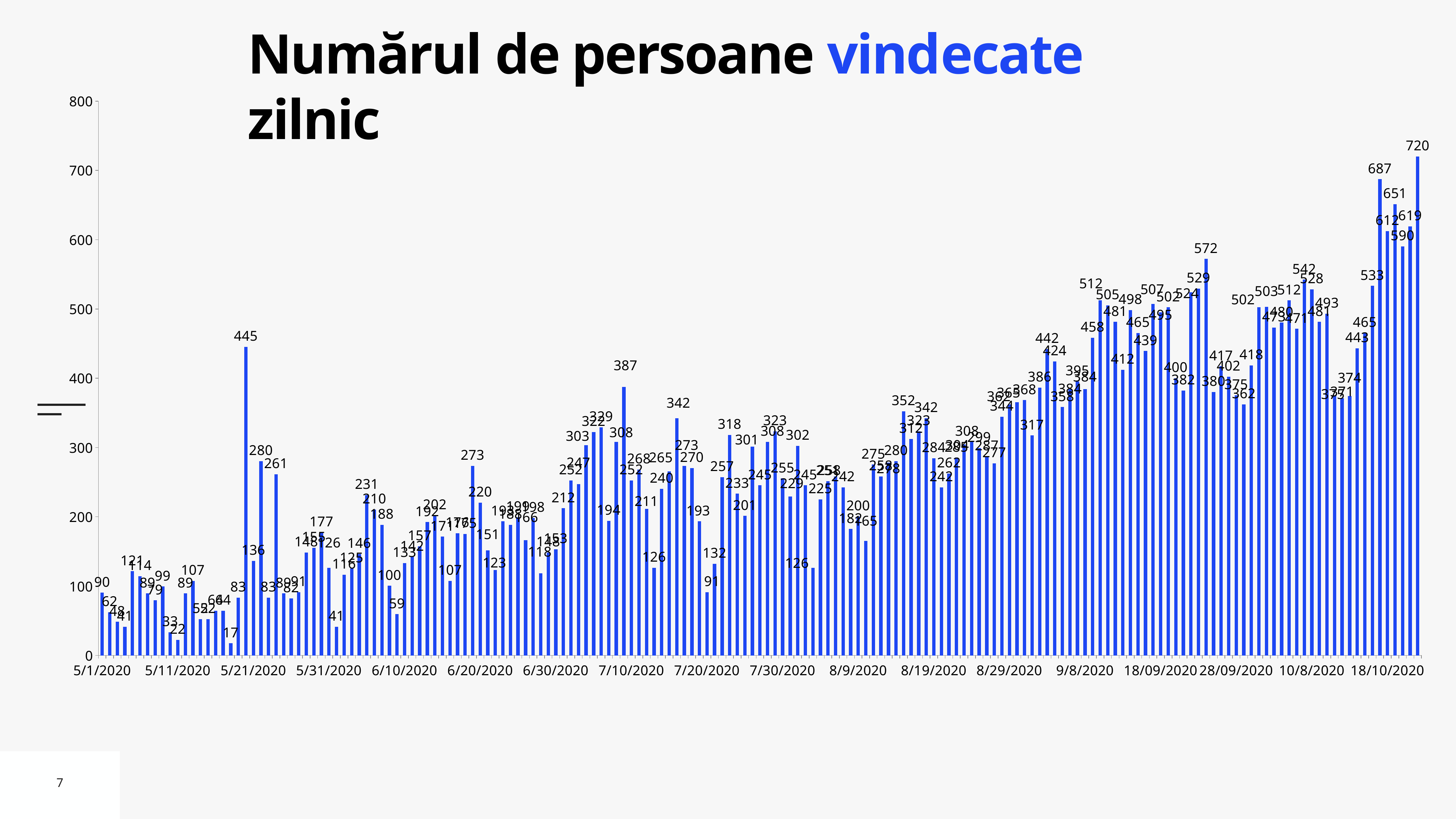
What is the difference between the highest bar (720) and the second highest bar (687)? 33 What is the difference between the bar labeled 445 in May and the bar labeled 387 in July? 58 Which is larger, the value for 5/1/2020 or the value of the last bar in the chart? the last bar What is the value for 5/1/2020, the first bar in the chart? 90 What is the maximum value shown on the vertical axis? 800 What is the title of the chart? Numărul de persoane vindecate zilnic What is the highest daily value shown in the chart? 720 What kind of chart is shown on the slide? bar chart What is the lowest daily value shown in the chart? 17 Is the value for 5/1/2020 greater or less than 100? less Do the daily values generally rise or fall from left to right along the x axis? rise What is the value for 5/11/2020? 22